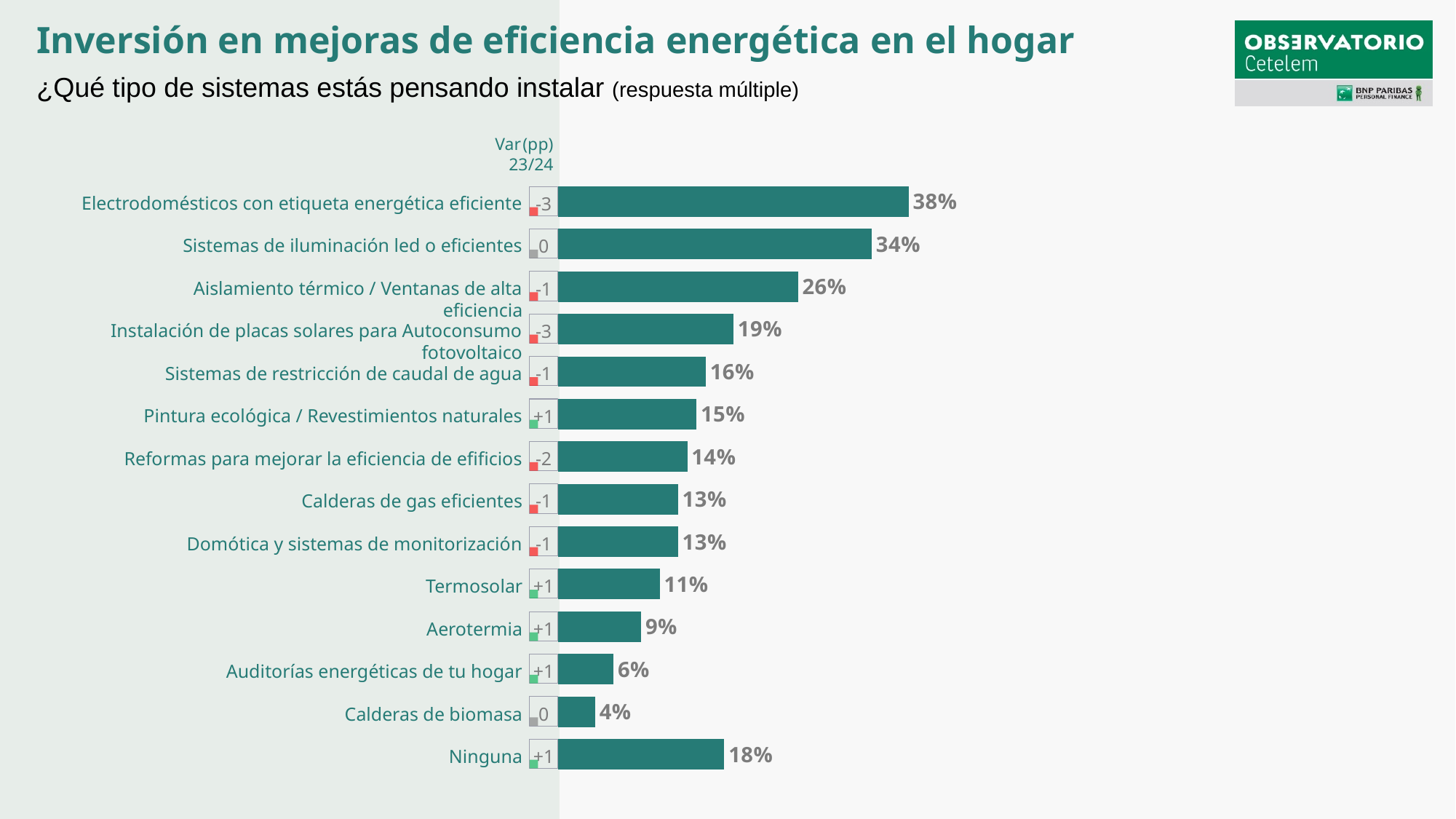
What kind of chart is shown on the slide? Bar chart What percentage of respondents are thinking of installing 'Electrodomésticos con etiqueta energética eficiente'? 38% What is the title of the slide containing the chart? Inversión en mejoras de eficiencia energética en el hogar Which category has the lowest value in the chart? Calderas de biomasa How many categories are shown in the chart? 14 What is the difference between the values for 'Electrodomésticos con etiqueta energética eficiente' and 'Sistemas de iluminación led o eficientes'? 4 percentage points Which category has the highest value in the chart? Electrodomésticos con etiqueta energética eficiente Which is larger: the value for 'Termosolar' or the value for 'Aerotermia'? Termosolar What is the value shown for 'Sistemas de iluminación led o eficientes'? 34% What is the Var(pp) 23/24 value shown for 'Auditorías energéticas de tu hogar'? +1 What is the value shown for 'Ninguna'? 18% What is the Var(pp) 23/24 value shown for 'Instalación de placas solares para Autoconsumo fotovoltaico'? -3